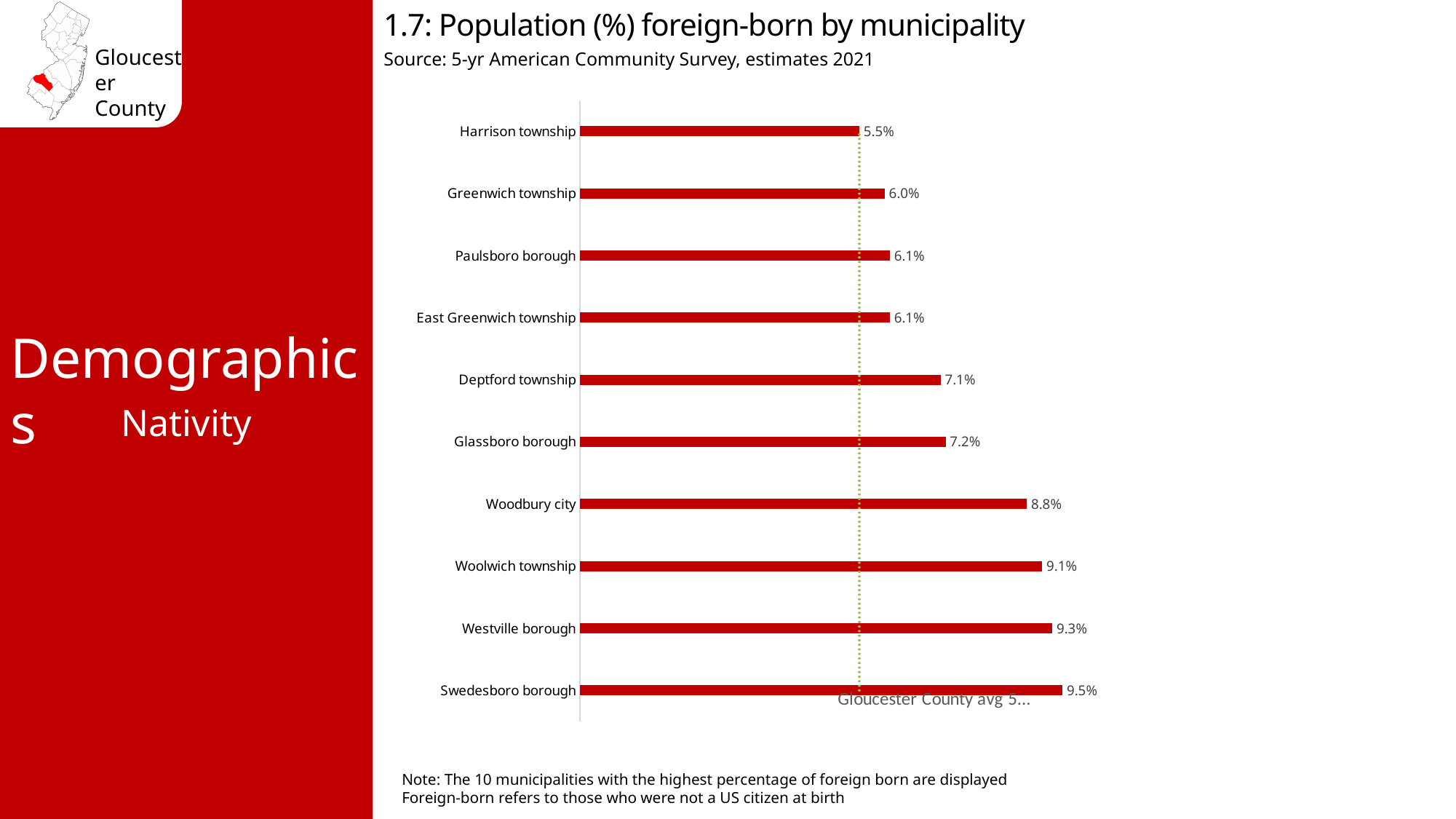
What type of chart is used on this slide? Bar chart Which has a higher foreign-born percentage, Westville borough or Woodbury city? Westville borough What is the difference in foreign-born percentage between Woolwich township and Glassboro borough? 1.9% Which municipality has the lowest percentage of foreign-born population? Harrison township What is the percentage of foreign-born population for Harrison township? 5.5% What is the percentage of foreign-born population for Woodbury city? 8.8% How many municipalities are shown in the chart? 10 What is the difference in foreign-born percentage between Swedesboro borough and Harrison township? 4.0% What is the percentage of foreign-born population for Swedesboro borough? 9.5% What is the percentage of foreign-born population for Deptford township? 7.1% Which municipality has the highest percentage of foreign-born population? Swedesboro borough What is the title of the chart? 1.7: Population (%) foreign-born by municipality